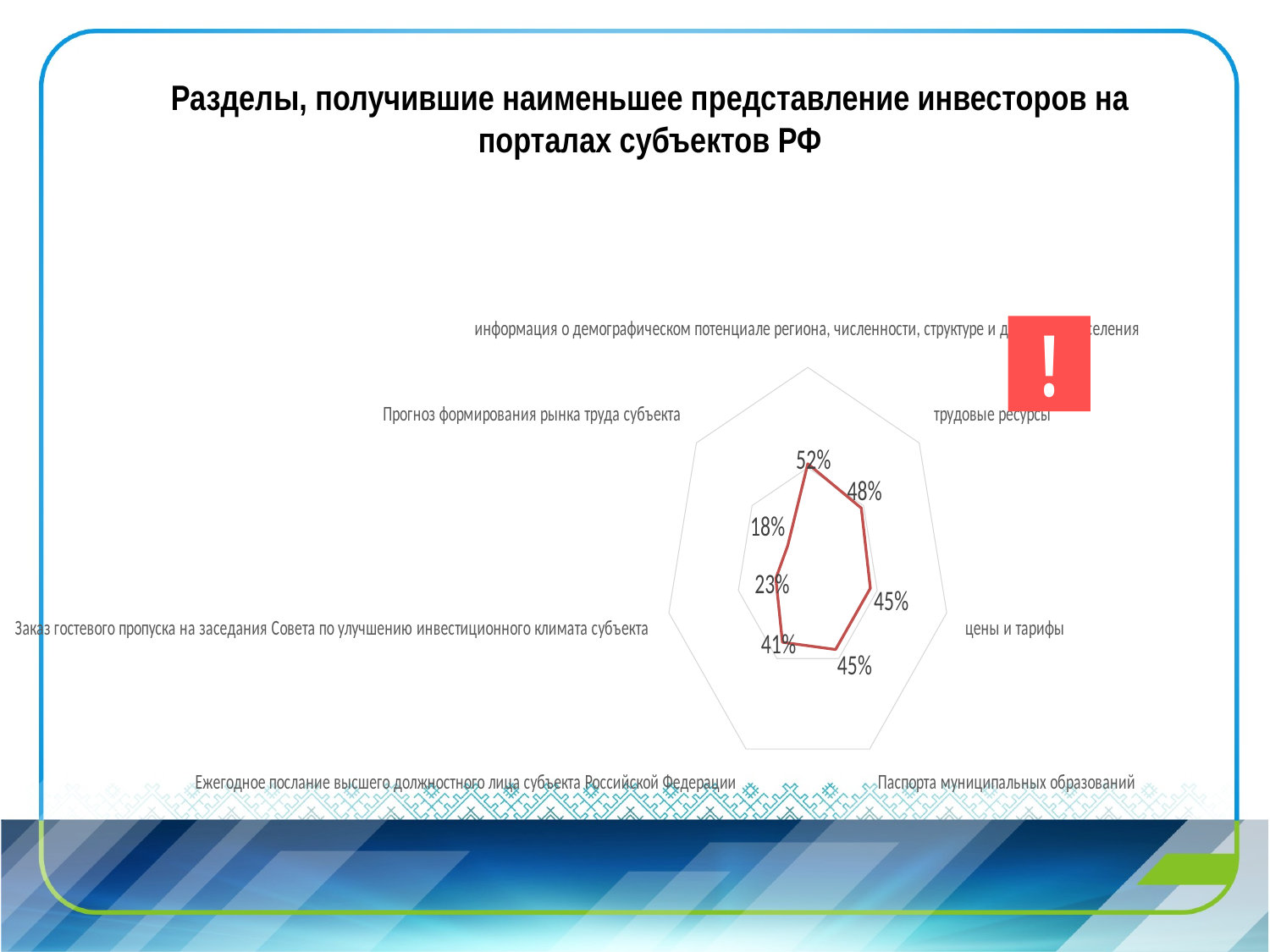
What is the value for 'Прогноз формирования рынка труда субъекта'? 18% What is the value for 'Заказ гостевого пропуска на заседания Совета по улучшению инвестиционного климата субъекта'? 23% What is the difference between the value for 'трудовые ресурсы' and the value for 'Прогноз формирования рынка труда субъекта'? 30 percentage points Which category has the lowest value on the radar chart? Прогноз формирования рынка труда субъекта Which category has the highest value on the radar chart? информация о демографическом потенциале региона (52%) What is the value for 'трудовые ресурсы'? 48% What kind of chart is shown on the slide? Radar chart What is the value for 'цены и тарифы'? 45% How many categories does the radar chart have? 7 What is the value for 'Паспорта муниципальных образований'? 45% Which is larger: the value for 'Ежегодное послание высшего должностного лица субъекта Российской Федерации' or the value for 'Заказ гостевого пропуска на заседания Совета по улучшению инвестиционного климата субъекта'? Ежегодное послание высшего должностного лица субъекта Российской Федерации What is the value for 'Ежегодное послание высшего должностного лица субъекта Российской Федерации'? 41%